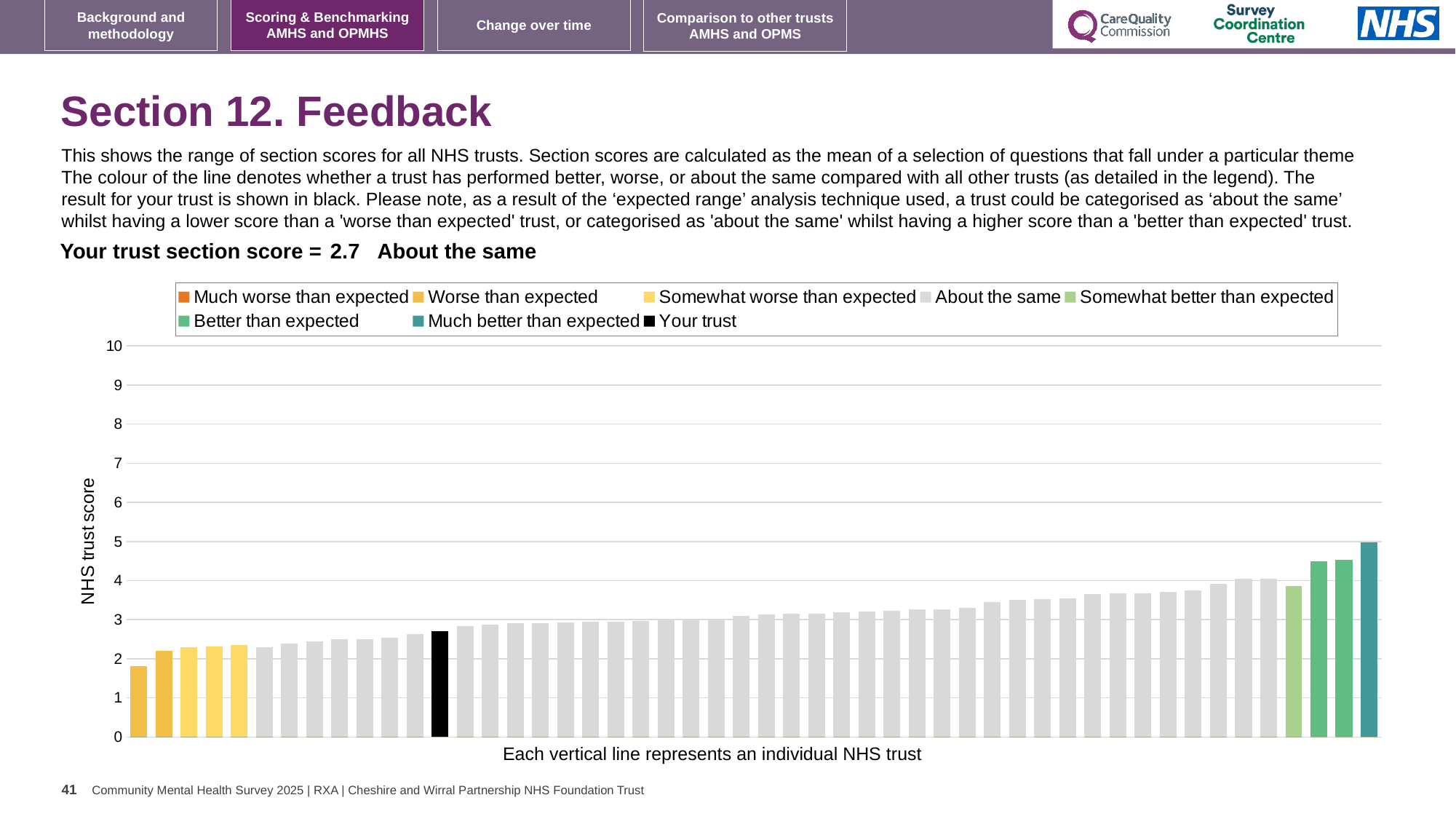
Which category is your trust's section score placed in? About the same What colour is used for the 'Your trust' bar in the chart? black Is the value of the tallest bar greater or less than 4? greater How many entries does the chart legend list? 8 Is the value of the black 'Your trust' bar greater or less than 2? greater Do the bar values rise or fall from left to right along the x axis? rise Is the value of the black 'Your trust' bar greater or less than 3? less Which legend category does the tallest bar belong to? Much better than expected What is the label on the vertical axis of the chart? NHS trust score What kind of chart is shown on the slide? bar chart What is the section score for your trust shown on the slide? 2.7